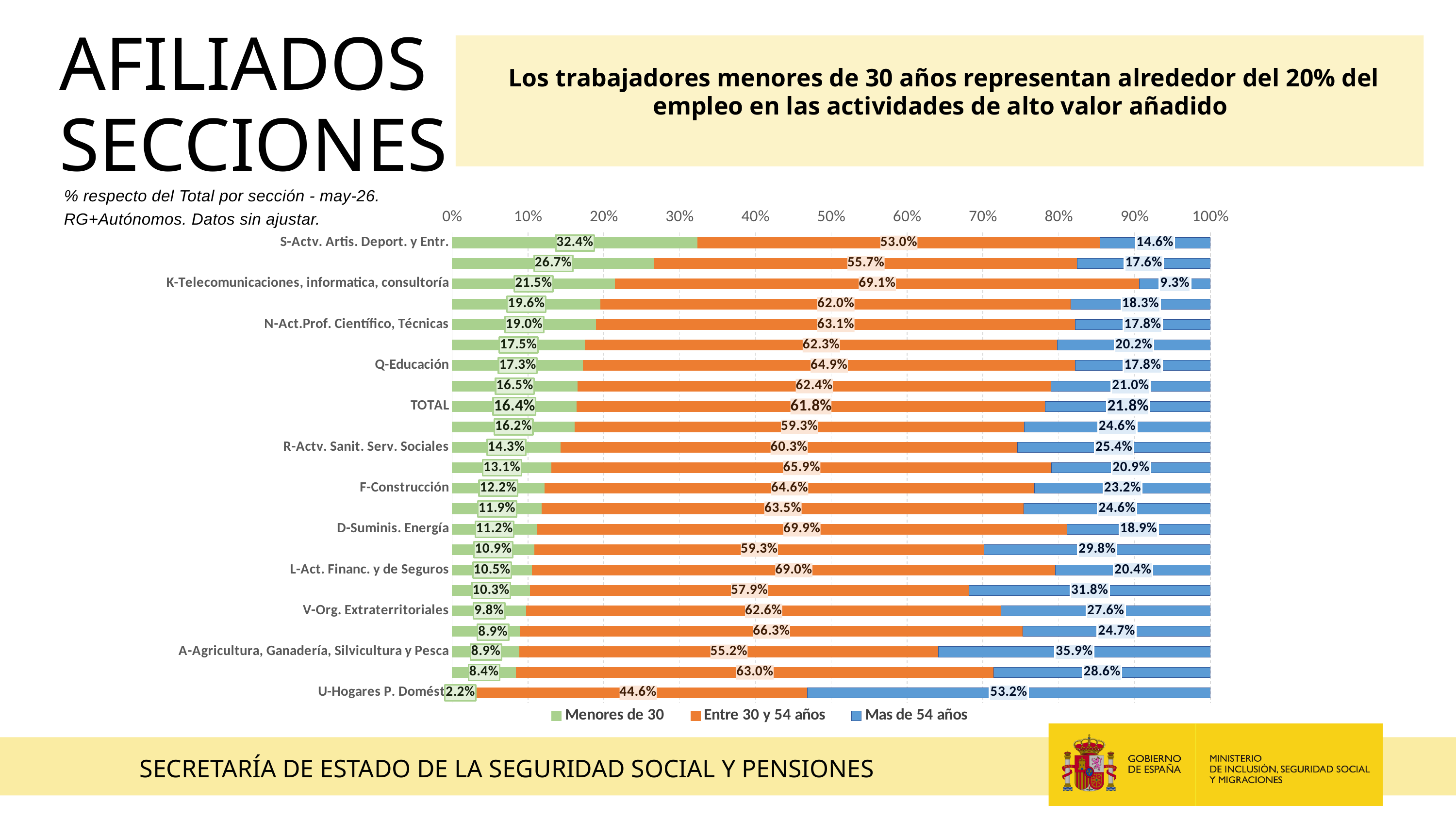
How many series does the legend list? 3 Which is larger: the 'Mas de 54 años' value for A-Agricultura, Ganadería, Silvicultura y Pesca or for F-Construcción? A-Agricultura, Ganadería, Silvicultura y Pesca What is the value of 'Entre 30 y 54 años' for K-Telecomunicaciones, informatica, consultoría? 69.1% What is the value of 'Menores de 30' for TOTAL? 16.4% What is the value of 'Mas de 54 años' for U-Hogares P. Domést? 53.2% Which category has the lowest value for 'Menores de 30'? U-Hogares P. Domést What kind of chart is shown on the slide? Stacked bar chart What is the value of 'Menores de 30' for S-Actv. Artis. Deport. y Entr.? 32.4% What is the difference between the 'Menores de 30' values for S-Actv. Artis. Deport. y Entr. and Q-Educación? 15.1% Which category has the lowest value for 'Mas de 54 años'? K-Telecomunicaciones, informatica, consultoría What is the total of the stacked bar for TOTAL? 100.0% Which category has the highest value for 'Menores de 30'? S-Actv. Artis. Deport. y Entr.